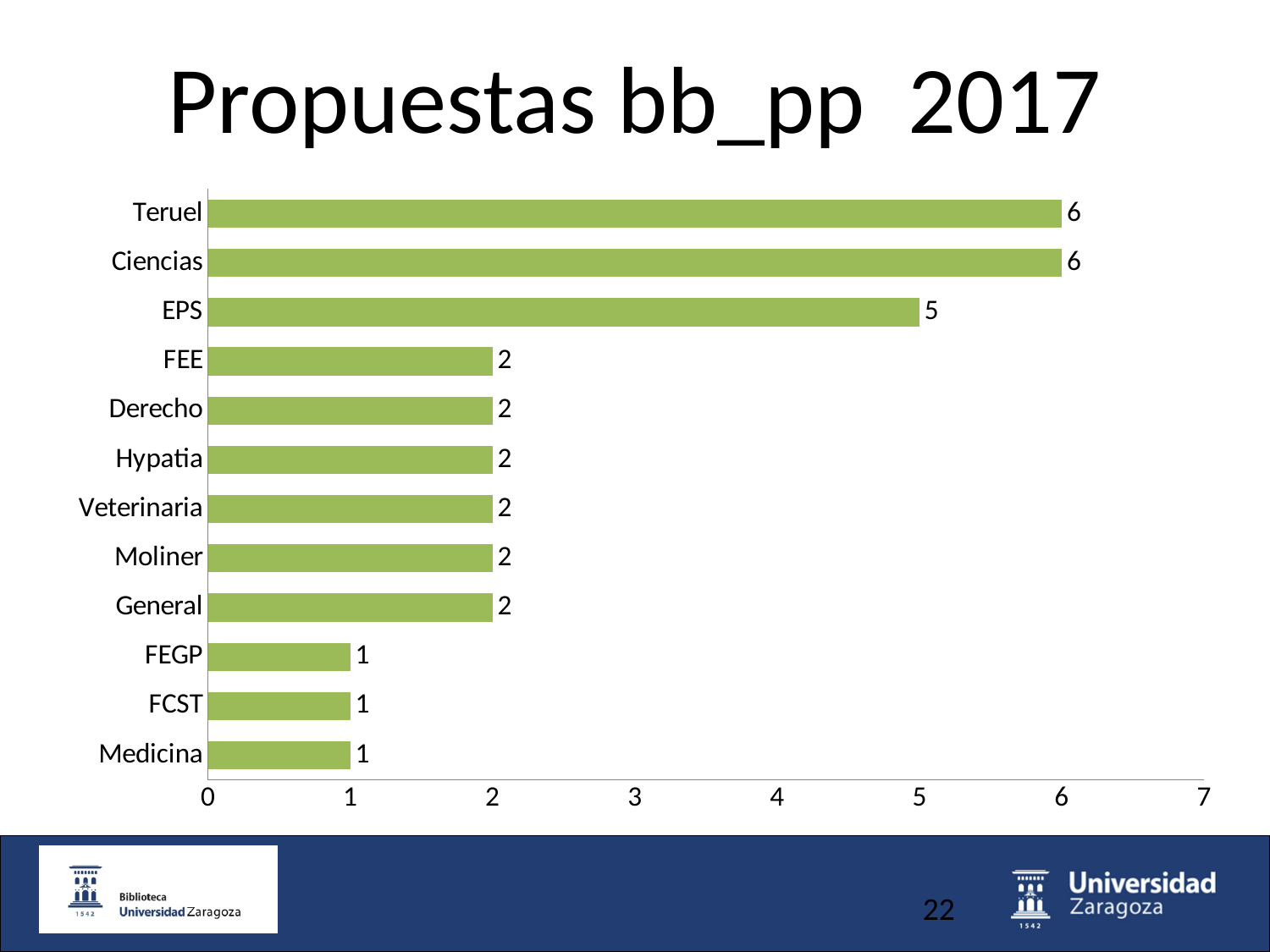
What is the title of the slide? Propuestas bb_pp 2017 What is the value for EPS? 5 What is the value for Veterinaria? 2 What is the value for Teruel? 6 Which is larger, the value for EPS or the value for Derecho? EPS What kind of chart is shown on the slide? bar chart Is the value for Teruel greater or less than 4? greater What is the difference between the values for EPS and FEE? 3 What is the value for Medicina? 1 How many categories are shown in the chart? 12 Which category has the lowest value among Teruel, EPS and FEGP? FEGP What is the difference between the values for Ciencias and EPS? 1